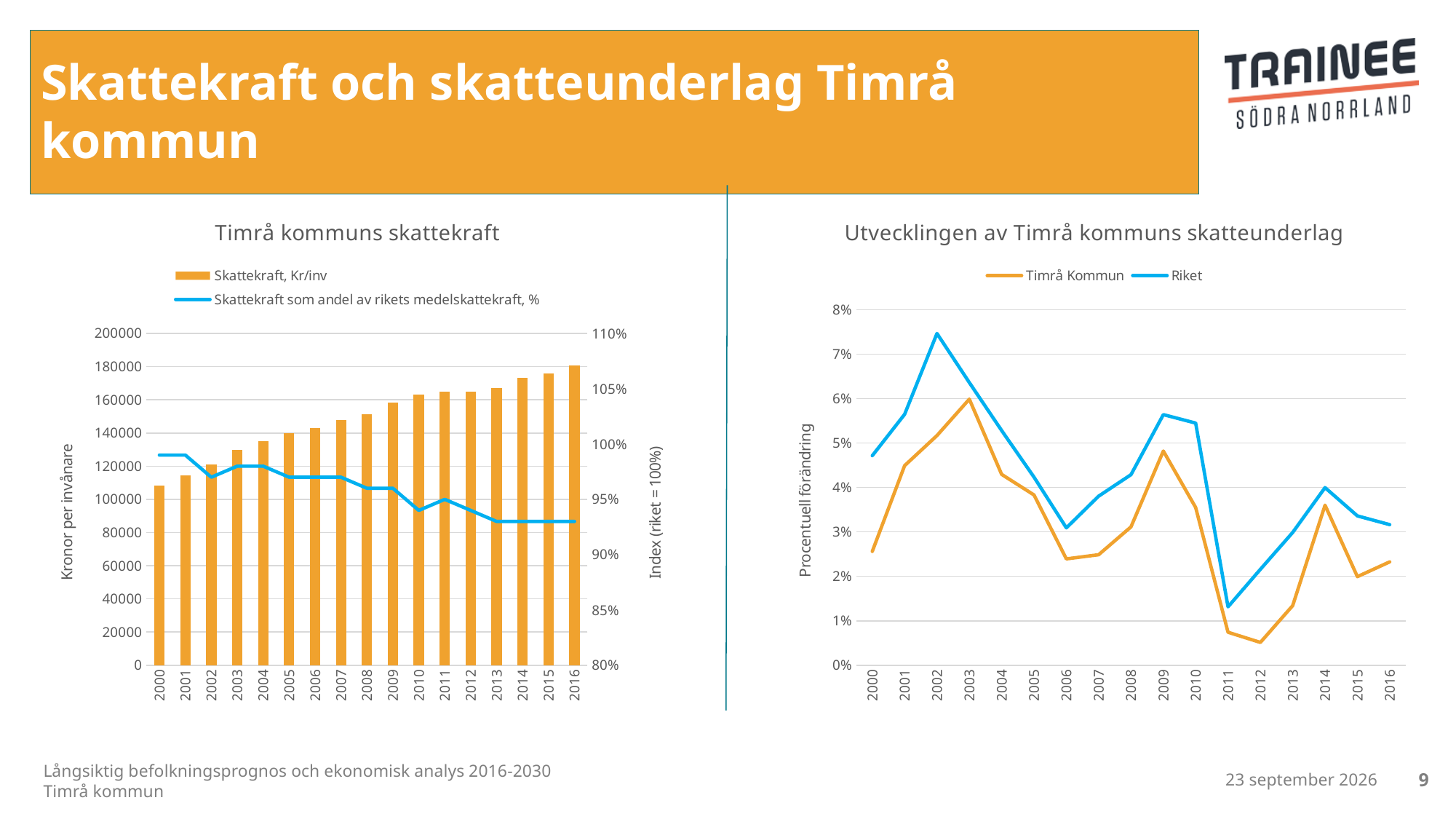
In the chart 'Timrå kommuns skattekraft', do the 'Skattekraft, Kr/inv' bars generally rise or fall from 2000 to 2016? rise In the chart 'Utvecklingen av Timrå kommuns skatteunderlag', which year has the lowest value for 'Timrå Kommun'? 2012 In the chart 'Utvecklingen av Timrå kommuns skatteunderlag', which series has the higher value in 2002, 'Timrå Kommun' or 'Riket'? Riket In the chart 'Utvecklingen av Timrå kommuns skatteunderlag', is the 'Timrå Kommun' value for 2011 greater or less than 1%? less In the chart 'Timrå kommuns skattekraft', how many years are shown on the x axis? 17 In the chart 'Timrå kommuns skattekraft', is the 'Skattekraft som andel av rikets medelskattekraft, %' value for 2016 greater or less than 95%? less In the chart 'Timrå kommuns skattekraft', which year has the highest value for 'Skattekraft, Kr/inv'? 2016 In the chart 'Timrå kommuns skattekraft', what kind of chart is used for the series 'Skattekraft, Kr/inv'? bar chart In the chart 'Utvecklingen av Timrå kommuns skatteunderlag', which year has the highest value for 'Riket'? 2002 In the chart 'Timrå kommuns skattekraft', is the 'Skattekraft, Kr/inv' value for 2016 greater or less than 160000? greater In the chart 'Timrå kommuns skattekraft', which year has the lowest value for 'Skattekraft, Kr/inv'? 2000 In the chart 'Utvecklingen av Timrå kommuns skatteunderlag', how many series does the legend list? 2